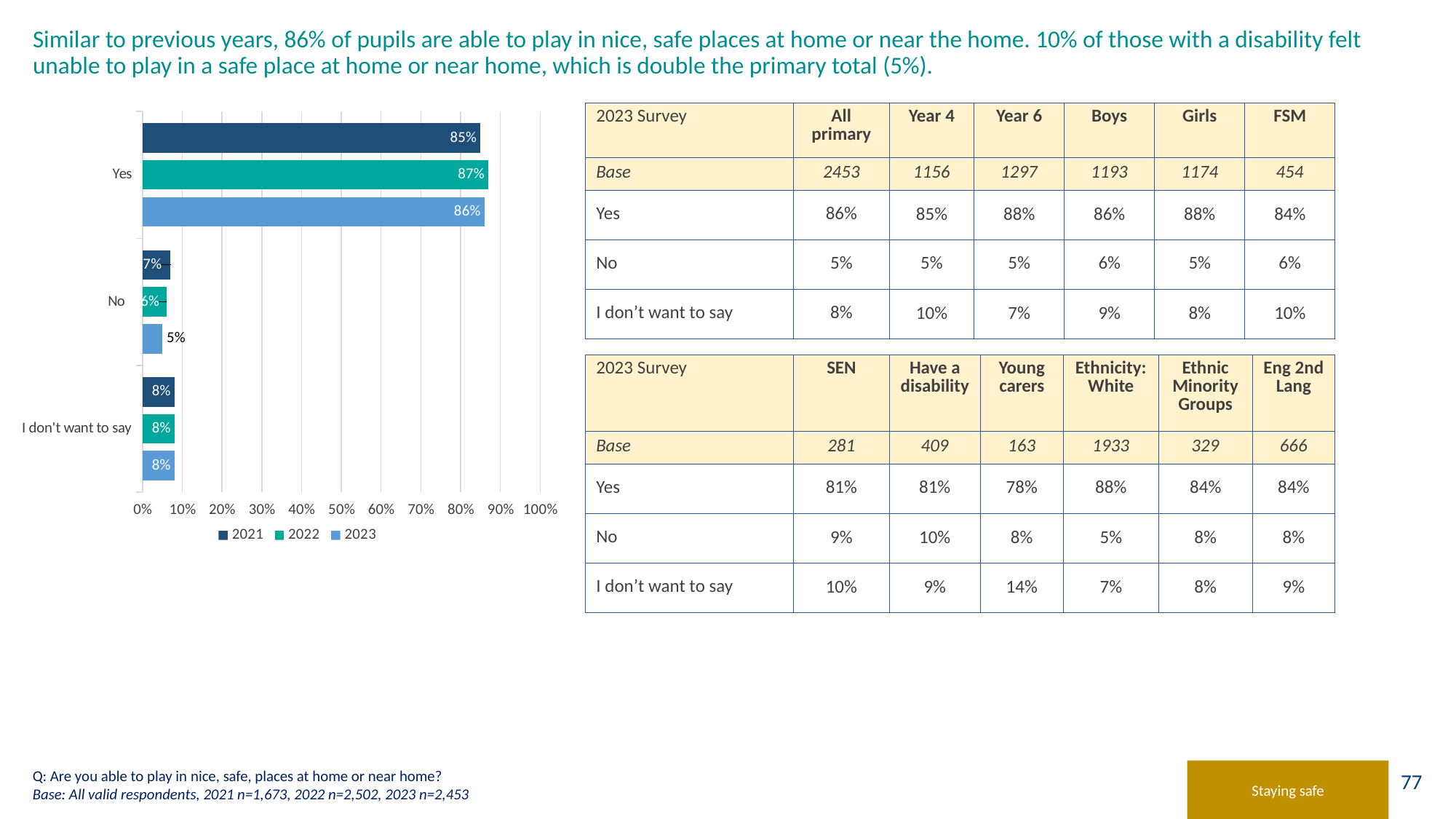
What is the value for 'Yes' in the 2022 series? 87% What is the value for 'Yes' in the 2021 series? 85% How many categories are shown on the chart? 3 Which year has the highest value for 'Yes'? 2022 What is the value for 'I don't want to say' in the 2021 series? 8% What is the difference between the 2022 and 2021 values for 'Yes'? 2% What kind of chart is shown on the slide? bar chart What is the value for 'No' in the 2023 series? 5% How many series does the legend list? 3 Is the 2021 value for 'No' larger or smaller than the 2023 value for 'No'? larger Which year has the lowest value for 'No'? 2023 Which series is shown in light blue in the legend? 2023